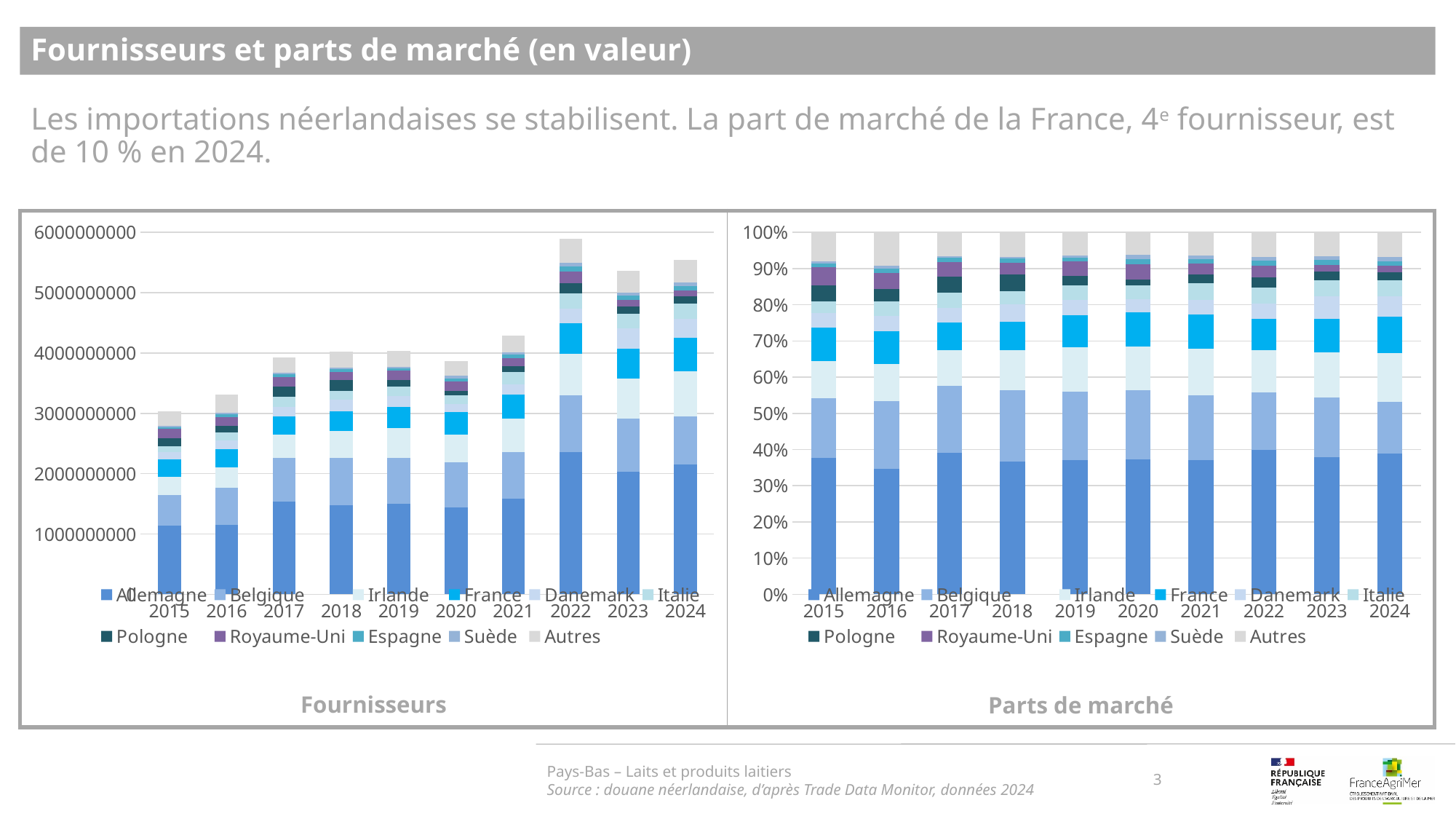
In the 'Parts de marché' chart, which supplier has the largest share in 2024? Allemagne How many series does the legend of the 'Fournisseurs' chart list? 11 In the 'Parts de marché' chart, is the share of Allemagne in 2024 greater or less than 30%? greater In the 'Fournisseurs' chart, is the total for 2020 greater or less than 4000000000? less What kind of chart is the 'Fournisseurs' chart on the left? Stacked bar chart How many years are shown on the x axis of the 'Parts de marché' chart? 10 In the 'Fournisseurs' chart, which year has the tallest stacked bar? 2022 In the 'Fournisseurs' chart, which year has the shortest stacked bar? 2015 In the 'Fournisseurs' chart, is the total for 2022 greater or less than 5000000000? greater In the 'Fournisseurs' chart, do the total values generally rise or fall from 2015 to 2022? rise In the 'Fournisseurs' chart, which total is larger, 2022 or 2023? 2022